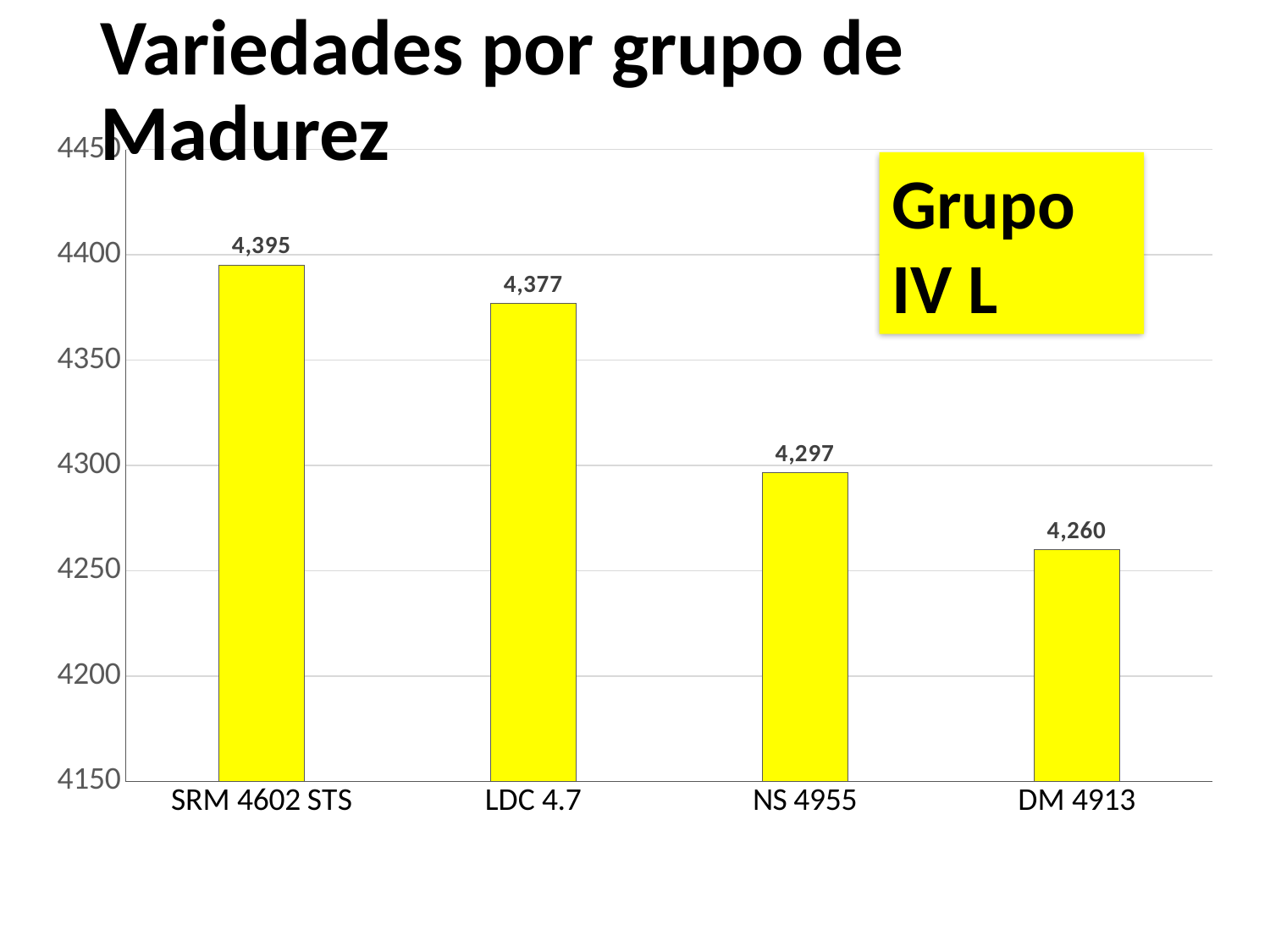
What is the value for NS 4955? 4,297 What is the value for LDC 4.7? 4,377 How many varieties are shown in the chart? 4 What is the difference between the values for SRM 4602 STS and DM 4913? 135 Which is larger, the value for LDC 4.7 or the value for NS 4955? LDC 4.7 What is the value for SRM 4602 STS? 4,395 Which variety has the lowest value? DM 4913 What is the value for DM 4913? 4,260 Do the values rise or fall from left to right across the x axis? fall What is the difference between the values for LDC 4.7 and NS 4955? 80 What kind of chart is shown on the slide? bar chart Which variety has the highest value? SRM 4602 STS